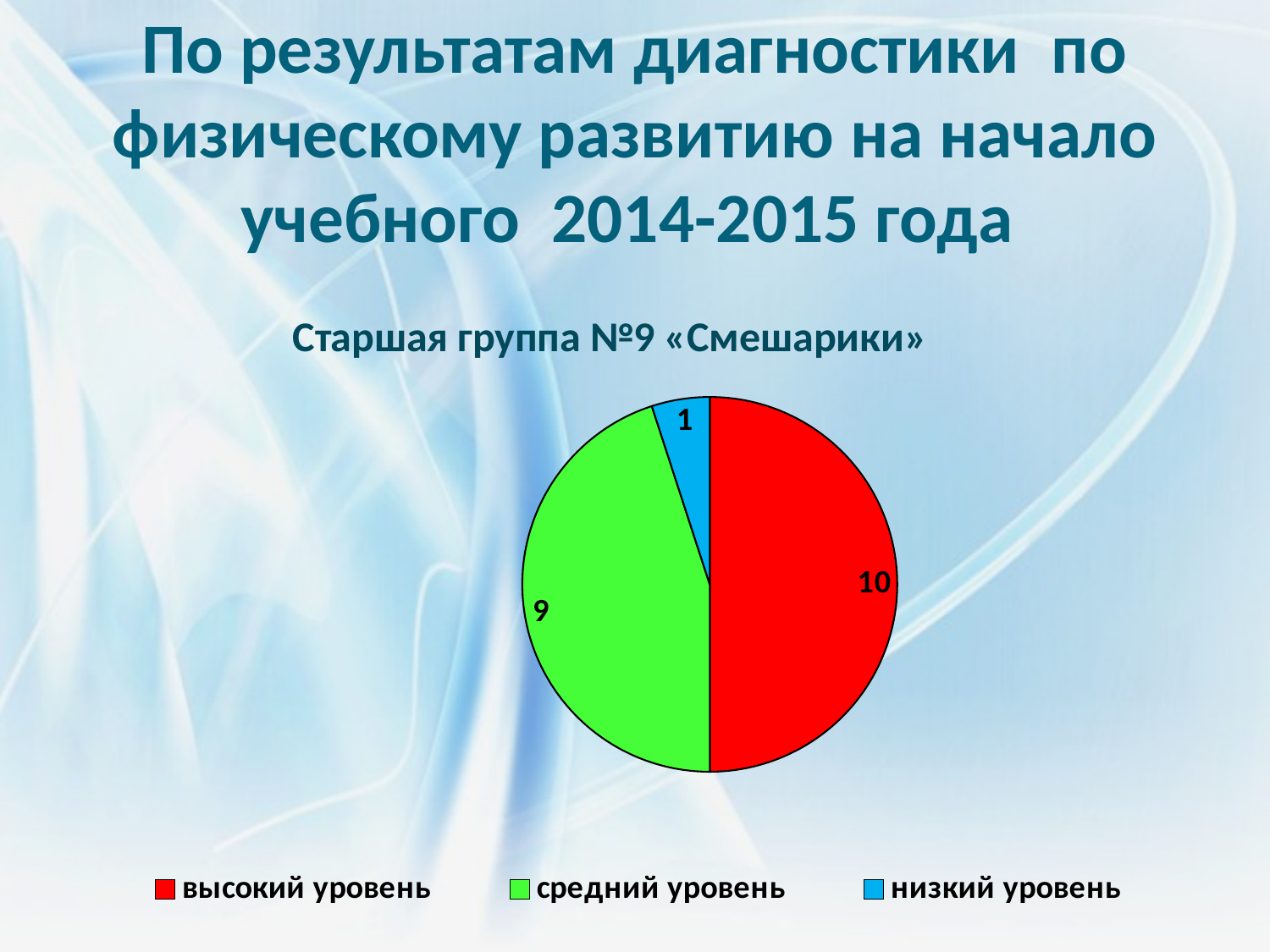
How many slices does the pie chart have? 3 What is the value for средний уровень? 9 What type of chart is shown on the slide? pie chart Which category has the smallest slice? низкий уровень What is the value for высокий уровень? 10 How many entries does the legend list? 3 What share of the pie does высокий уровень represent? 50% What is the value for низкий уровень? 1 Which is larger, the value for средний уровень or the value for низкий уровень? средний уровень What is the difference between the values for высокий уровень and низкий уровень? 9 Which category has the largest slice? высокий уровень What is the total of all slices in the pie chart? 20